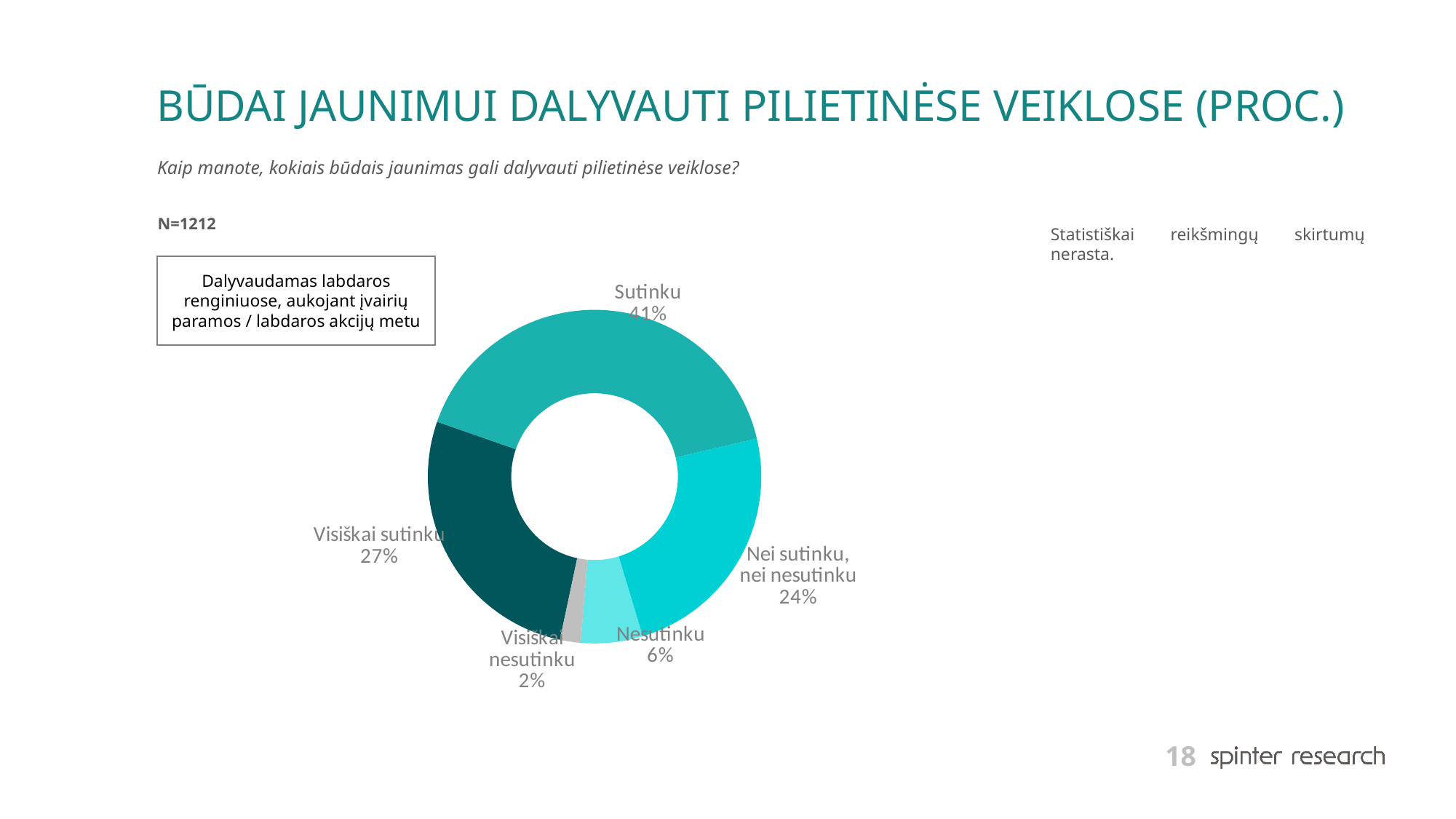
Which is larger: the share for "Visiškai sutinku" or for "Nei sutinku, nei nesutinku"? Visiškai sutinku What percentage of respondents answered "Nei sutinku, nei nesutinku"? 24% What percentage of respondents answered "Visiškai sutinku"? 27% What percentage of respondents answered "Visiškai nesutinku"? 2% What type of chart is shown on the slide? Doughnut (pie) chart What is the sample size (N) stated on the slide? N=1212 How many response categories are shown in the chart? 5 What percentage of respondents answered "Sutinku"? 41% What percentage of respondents answered "Nesutinku"? 6% What is the difference in percentage points between "Sutinku" and "Visiškai sutinku"? 14 Which response category has the largest share of the chart? Sutinku Which response category has the smallest share of the chart? Visiškai nesutinku